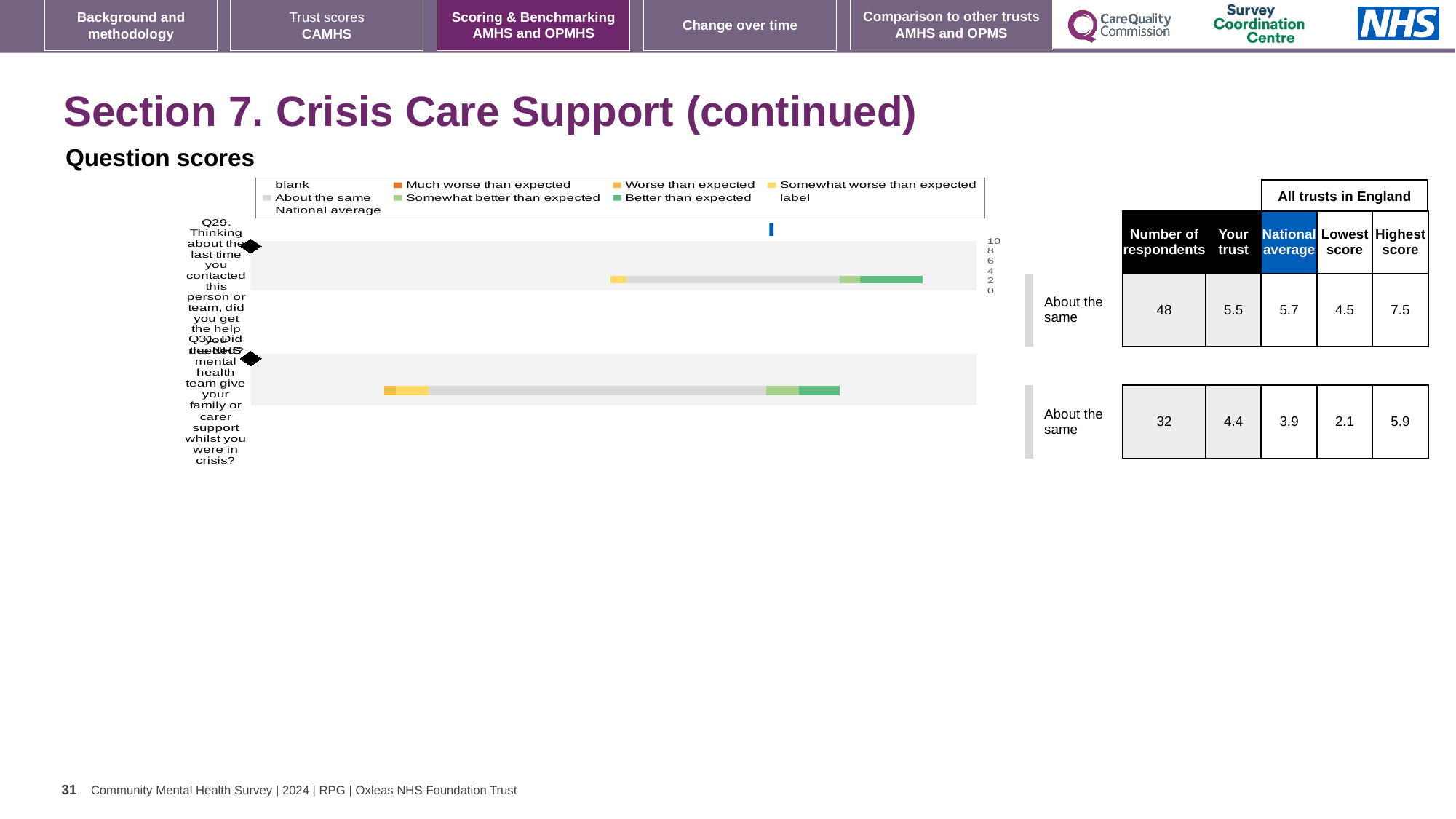
In the table beside the chart, what is the lowest score for Q29? 4.5 In the table beside the chart, what is the national average for Q29? 5.7 What is the difference between the 'Your trust' score and the national average for Q31 in the table? 0.5 What kind of chart is shown under 'Question scores'? bar chart In the table beside the chart, what is the 'Your trust' score for Q31? 4.4 In the table beside the chart, what is the number of respondents for Q29? 48 What colour represents 'Better than expected' in the chart legend? green What is the difference between the highest score and the lowest score for Q31 in the table? 3.8 Which question has the higher 'Your trust' score in the table, Q29 or Q31? Q29 How many entries does the legend of the 'Question scores' chart list? 9 How many questions (categories) are plotted in the 'Question scores' chart? 2 In the table beside the chart, what is the highest score for Q31? 5.9